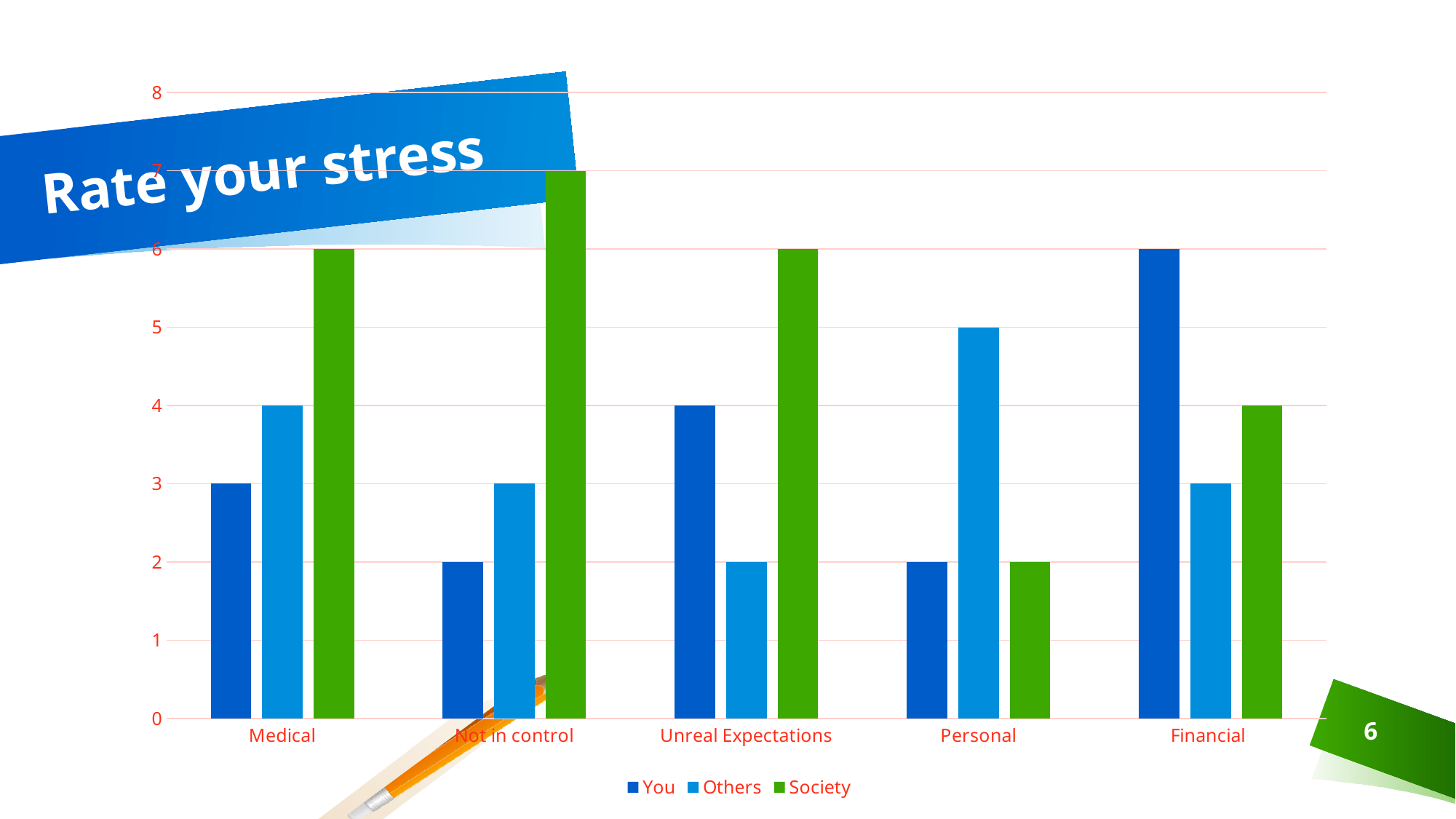
What is the value for You in the Medical category? 3 What kind of chart is shown on the slide? Bar chart Which is larger in the Unreal Expectations category, You or Others? You What is the value for Society in the Not in control category? 7 In which category is the Society value highest? Not in control What is the value for Others in the Personal category? 5 What is the difference between the Society and You values in the Medical category? 3 What is the value for You in the Financial category? 6 How many series does the legend list? 3 What is the title shown on the slide? Rate your stress In which category is the You value lowest? Not in control and Personal How many categories are shown on the x axis? 5